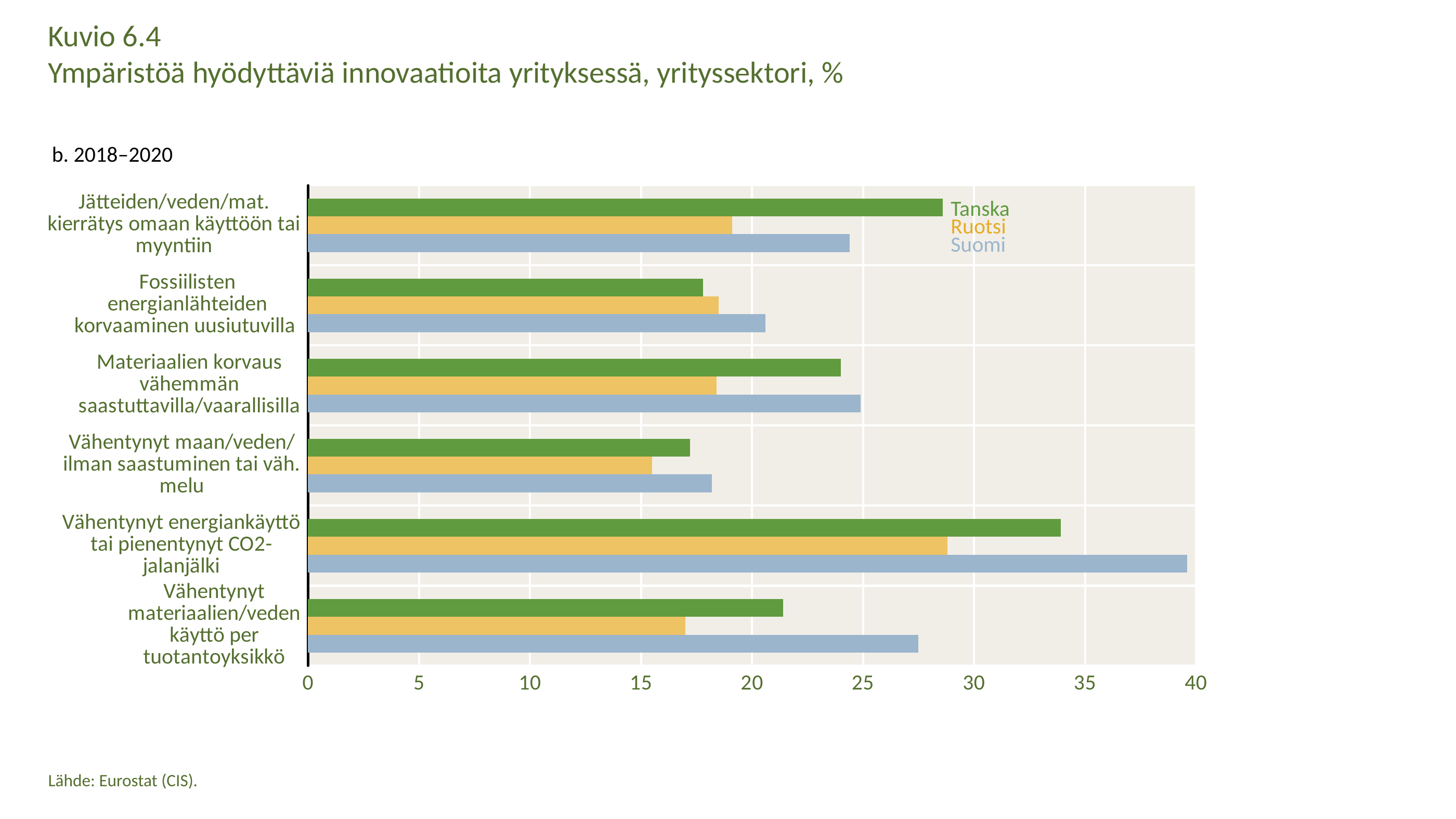
How many categories are shown on the vertical axis? 6 For Vähentynyt materiaalien/veden käyttö per tuotantoyksikkö, which is larger: the Suomi value or the Tanska value? Suomi Is the Tanska value for Jätteiden/veden/mat. kierrätys omaan käyttöön tai myyntiin greater or less than 25? greater For which category is the Suomi value highest? Vähentynyt energiankäyttö tai pienentynyt CO2-jalanjälki What kind of chart is shown on the slide? bar chart For Jätteiden/veden/mat. kierrätys omaan käyttöön tai myyntiin, which is larger: the Tanska value or the Suomi value? Tanska What source is cited for the chart? Eurostat (CIS) Is the Suomi value for Vähentynyt materiaalien/veden käyttö per tuotantoyksikkö greater or less than 25? greater Is the Ruotsi value for Vähentynyt energiankäyttö tai pienentynyt CO2-jalanjälki greater or less than 30? less How many series does the legend list? 3 For which category is the Ruotsi value lowest? Vähentynyt maan/veden/ilman saastuminen tai väh. melu Which colour represents Suomi in the chart? blue